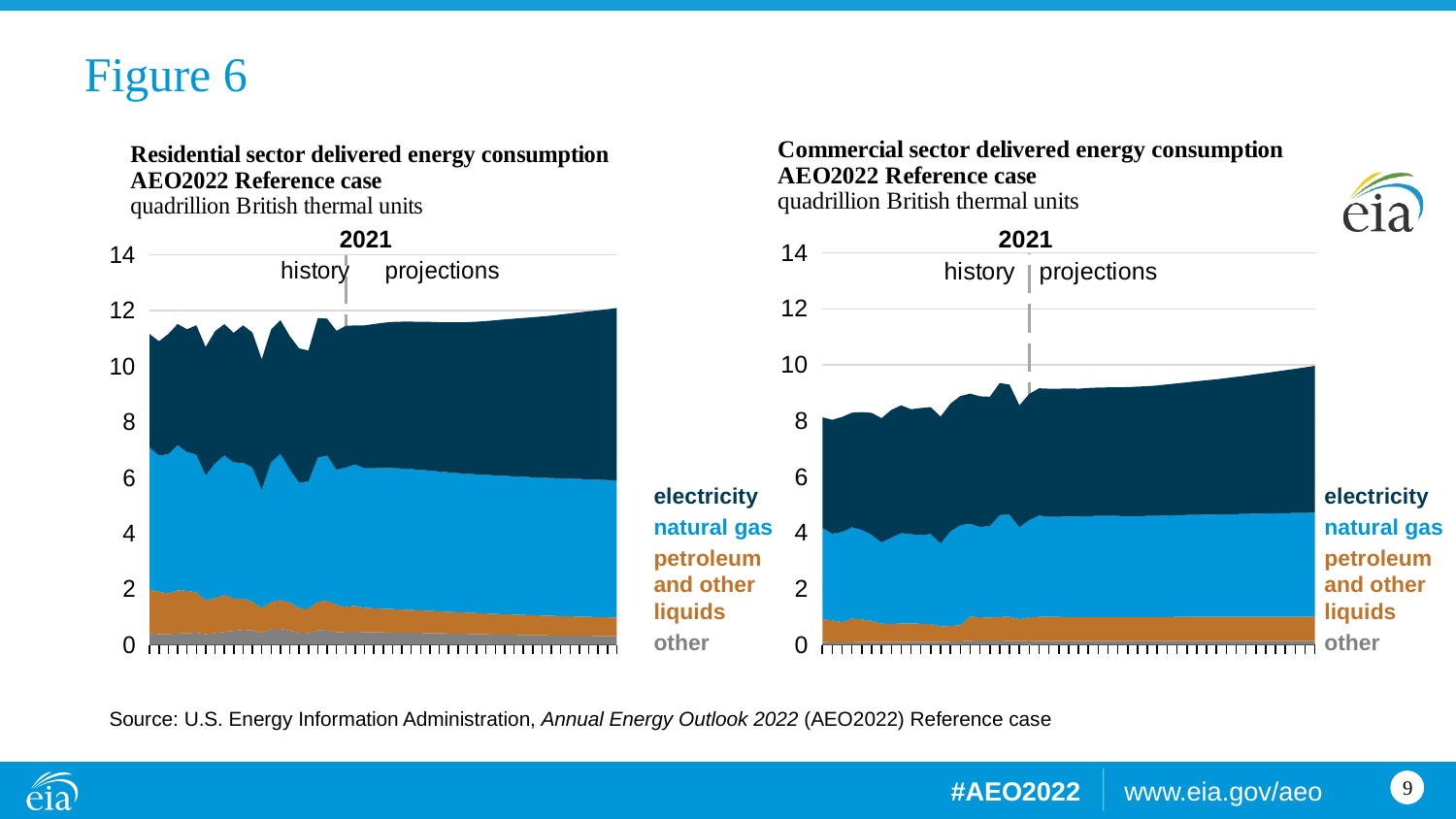
At the end of the projections period, which chart shows the higher total delivered energy consumption, Residential or Commercial? Residential In the Commercial sector delivered energy consumption chart, at the end of the projections period, which is larger, electricity or natural gas? electricity What kind of chart is the Residential sector delivered energy consumption chart? stacked area chart In the Residential sector delivered energy consumption chart, what unit is shown on the y axis? quadrillion British thermal units In the Commercial sector delivered energy consumption chart, is the total delivered energy consumption at the start of the history period greater or less than 10? less In the Commercial sector delivered energy consumption chart, does total delivered energy consumption rise or fall over the projections period? rise What kind of chart is the Commercial sector delivered energy consumption chart? stacked area chart How many series are listed in the legend of the Commercial sector delivered energy consumption chart? 4 In the Commercial sector delivered energy consumption chart, is the total delivered energy consumption at the start of the history period greater or less than 6? greater In the Commercial sector delivered energy consumption chart, which year separates history from projections? 2021 How many series are listed in the legend of the Residential sector delivered energy consumption chart? 4 In the Residential sector delivered energy consumption chart, is the total delivered energy consumption at the 2021 marker greater or less than 10? greater